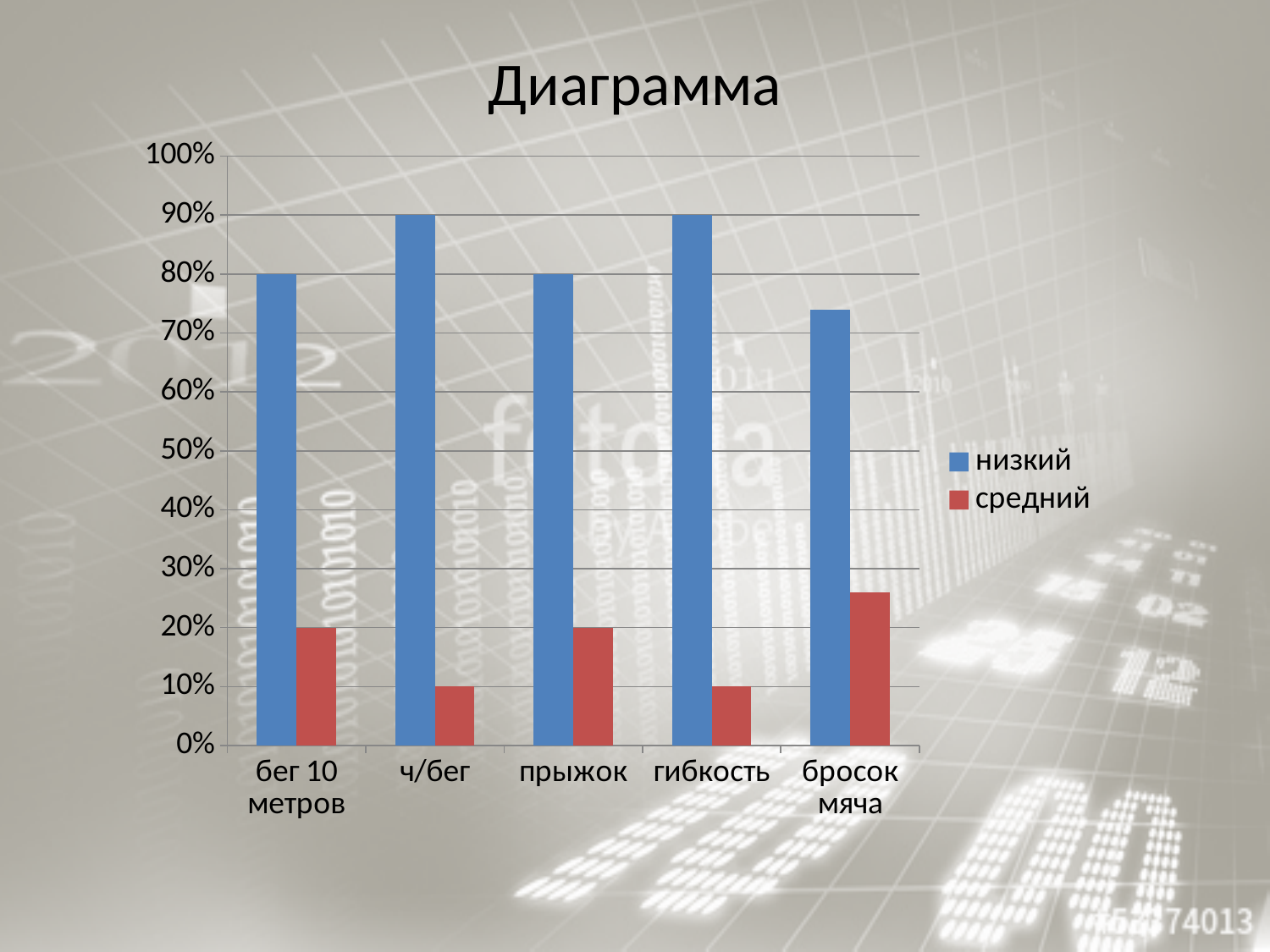
What is the difference between the низкий values for ч/бег and бег 10 метров? 10% How many categories are shown on the x axis? 5 Which category has the highest value in the средний series? бросок мяча What is the value of the низкий series for ч/бег? 90% What is the value of the низкий series for прыжок? 80% What kind of chart is shown on the slide? bar chart Which category has the lowest value in the низкий series? бросок мяча What is the value of the средний series for гибкость? 10% What is the title of the chart? Диаграмма Is the value of the низкий series for бросок мяча greater or less than 80%? less What is the value of the средний series for бег 10 метров? 20% How many series does the legend list? 2